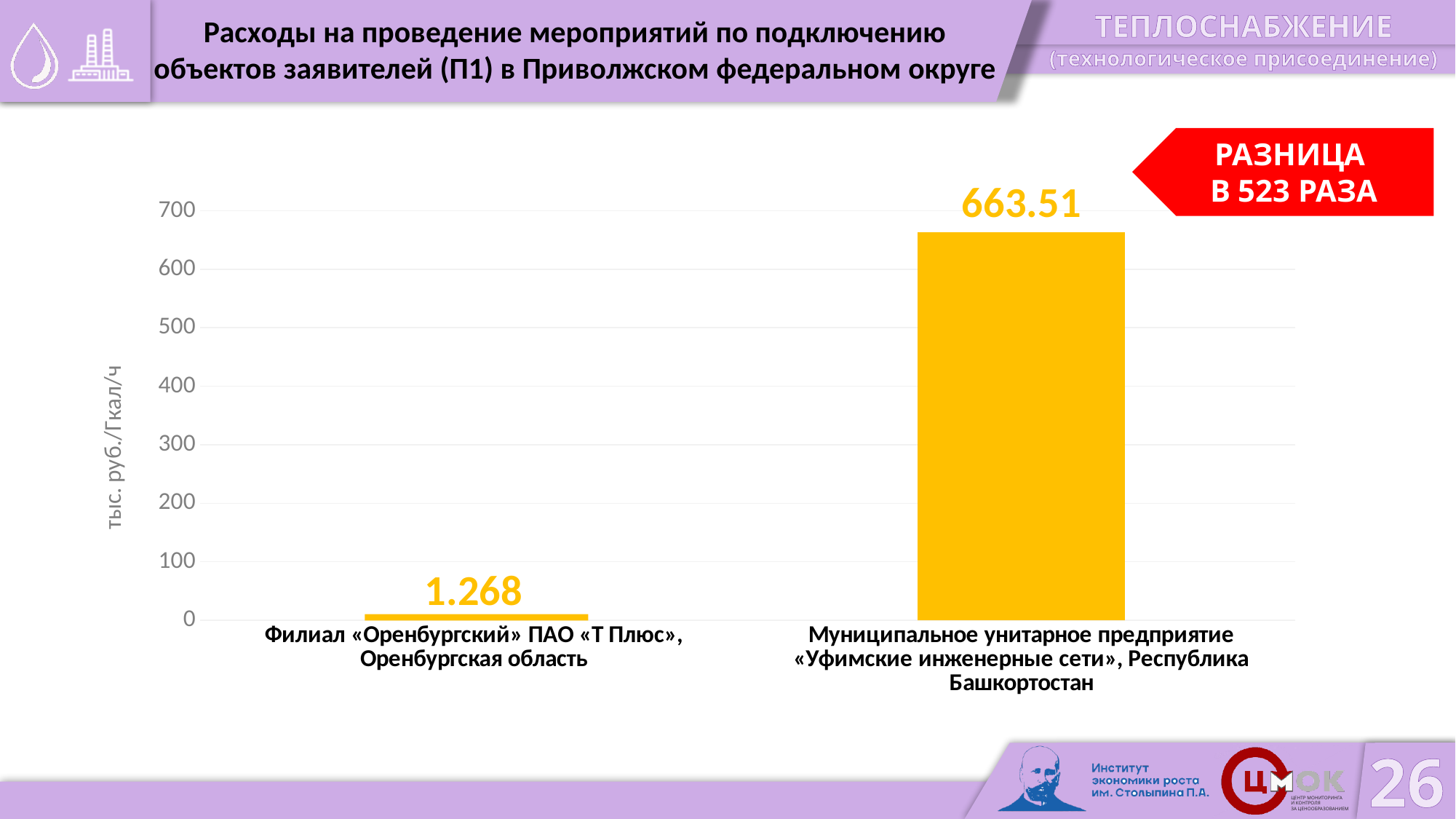
Is the value for Муниципальное унитарное предприятие «Уфимские инженерные сети» greater or less than 600? greater How many categories are shown in the chart? 2 Which is larger: the value for Филиал «Оренбургский» ПАО «Т Плюс» or the value for Муниципальное унитарное предприятие «Уфимские инженерные сети»? Муниципальное унитарное предприятие «Уфимские инженерные сети» What kind of chart is shown on the slide? bar chart Is the value for Филиал «Оренбургский» ПАО «Т Плюс» greater or less than 100? less According to the red callout on the slide, by how many times do the two values differ? В 523 раза Which category has the highest value? Муниципальное унитарное предприятие «Уфимские инженерные сети», Республика Башкортостан What is the value for Филиал «Оренбургский» ПАО «Т Плюс», Оренбургская область? 1.268 What is the value for Муниципальное унитарное предприятие «Уфимские инженерные сети», Республика Башкортостан? 663.51 What is the difference between the value for Муниципальное унитарное предприятие «Уфимские инженерные сети» and the value for Филиал «Оренбургский» ПАО «Т Плюс»? 662.242 Which category has the lowest value? Филиал «Оренбургский» ПАО «Т Плюс», Оренбургская область What is the unit shown on the vertical axis of the chart? тыс. руб./Гкал/ч